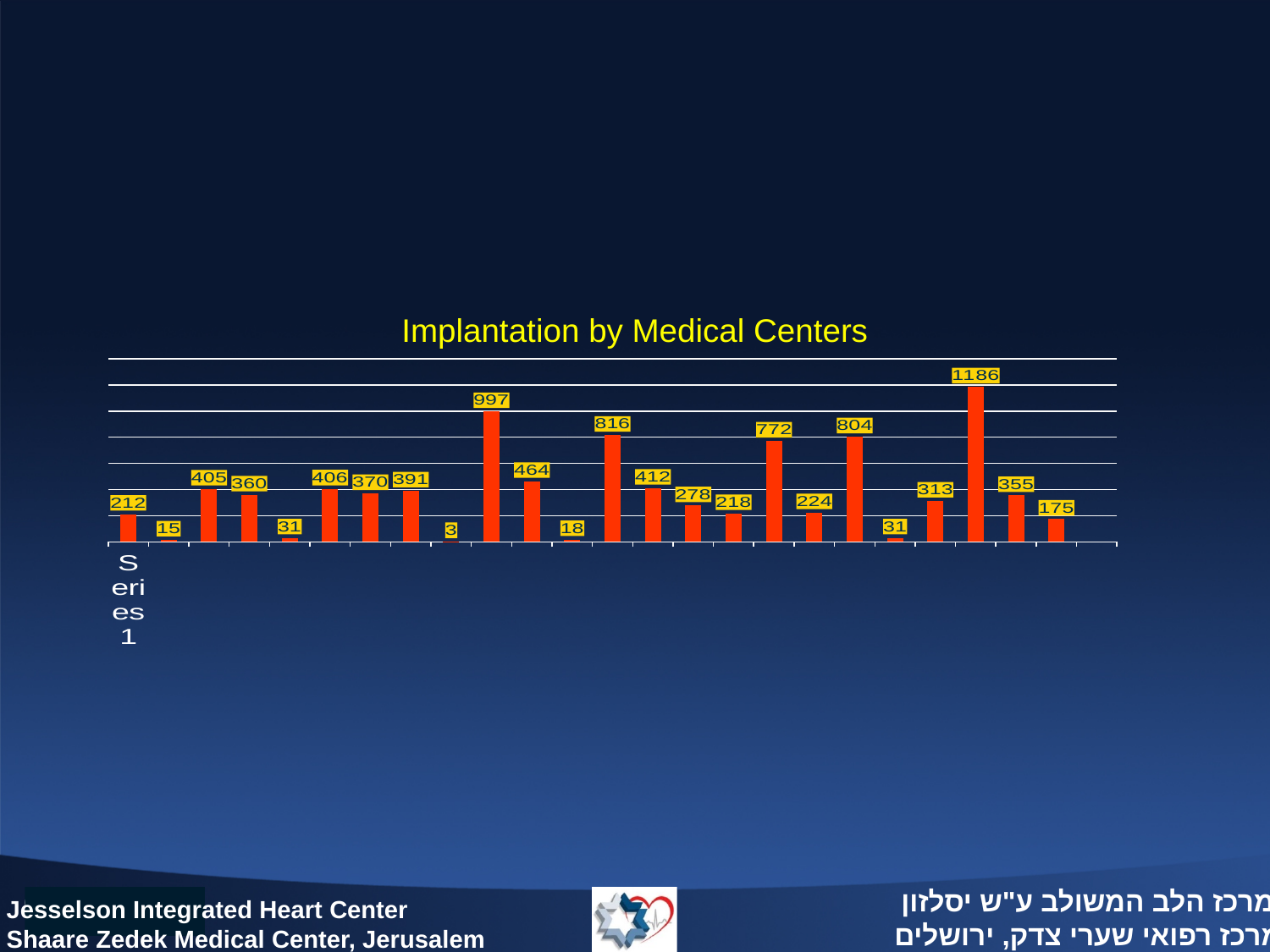
What is the highest value shown in the chart? 1186 What is the lowest value shown in the chart? 3 What is the difference between the highest value (1186) and the lowest value (3) in the chart? 1183 What is the value of the last (rightmost) bar in the chart? 175 What kind of chart is shown on the slide? bar chart What is the difference between the bar labelled 997 and the bar labelled 816? 181 How many series does the legend list? 1 How many bars are plotted in the chart? 24 What is the title of the chart? Implantation by Medical Centers What is the name of the series shown in the legend? Series 1 What is the value of the first (leftmost) bar in the chart? 212 Which is larger, the bar labelled 804 or the bar labelled 772? 804